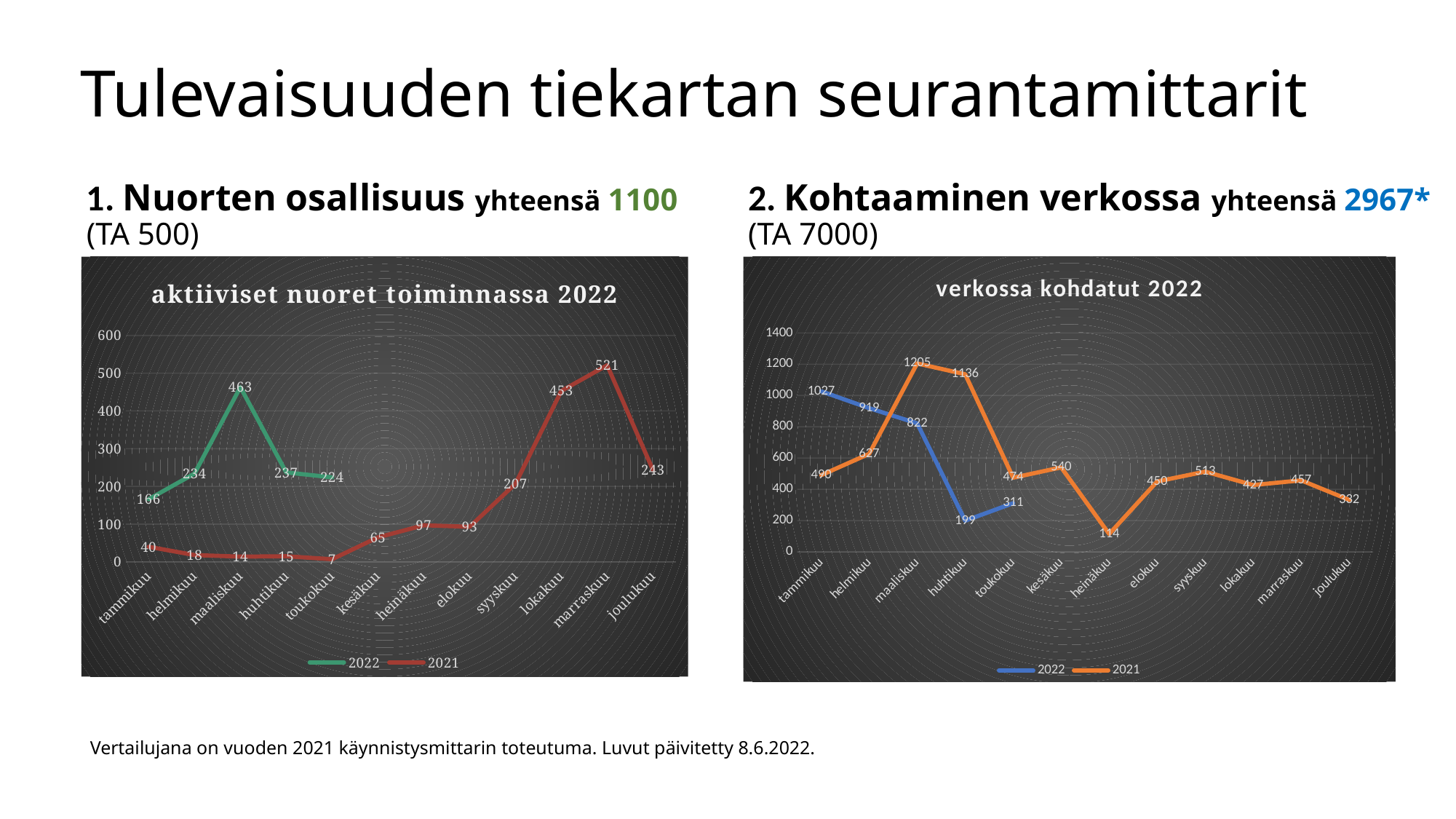
In the chart titled "aktiiviset nuoret toiminnassa 2022", how many series does the legend list? 2 In the chart titled "verkossa kohdatut 2022", what is the 2021 value for maaliskuu? 1205 In the chart titled "aktiiviset nuoret toiminnassa 2022", which month has the lowest 2021 value? toukokuu What kind of chart is the chart titled "verkossa kohdatut 2022"? line chart In the chart titled "verkossa kohdatut 2022", does the 2022 series rise or fall from tammikuu to huhtikuu? fall In the chart titled "aktiiviset nuoret toiminnassa 2022", what is the 2021 value for marraskuu? 521 In the chart titled "verkossa kohdatut 2022", which month has the highest 2022 value? tammikuu In the chart titled "verkossa kohdatut 2022", what is the 2022 value for huhtikuu? 199 In the chart titled "aktiiviset nuoret toiminnassa 2022", what is the 2022 value for maaliskuu? 463 In the chart titled "verkossa kohdatut 2022", which is larger for helmikuu: the 2022 value or the 2021 value? 2022 In the chart titled "aktiiviset nuoret toiminnassa 2022", what is the difference between the 2022 value and the 2021 value for tammikuu? 126 In the chart titled "verkossa kohdatut 2022", how many months are shown on the x axis? 12